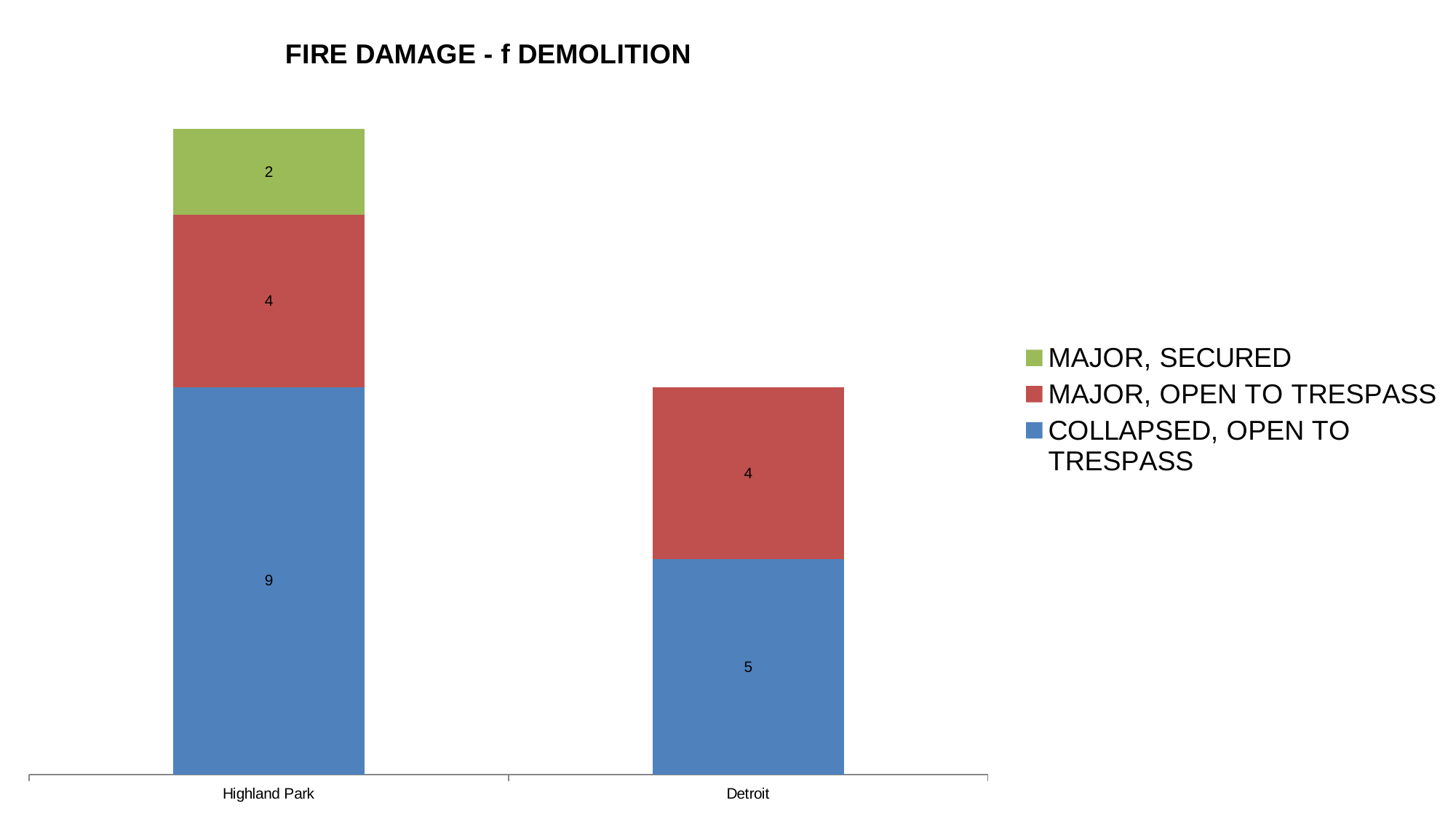
What kind of chart is shown on the slide? Stacked bar chart What is the difference between the COLLAPSED, OPEN TO TRESPASS values for Highland Park and Detroit? 4 What is the total of the stacked bar for Highland Park? 15 Which category has the larger COLLAPSED, OPEN TO TRESPASS value, Highland Park or Detroit? Highland Park What is the value for COLLAPSED, OPEN TO TRESPASS in Detroit? 5 What is the value for MAJOR, OPEN TO TRESPASS in Detroit? 4 What is the value for MAJOR, SECURED in Highland Park? 2 What is the total of the stacked bar for Detroit? 9 How many series does the legend list? 3 What is the value for COLLAPSED, OPEN TO TRESPASS in Highland Park? 9 Which category has the highest total stacked bar? Highland Park How many categories are shown on the x axis? 2